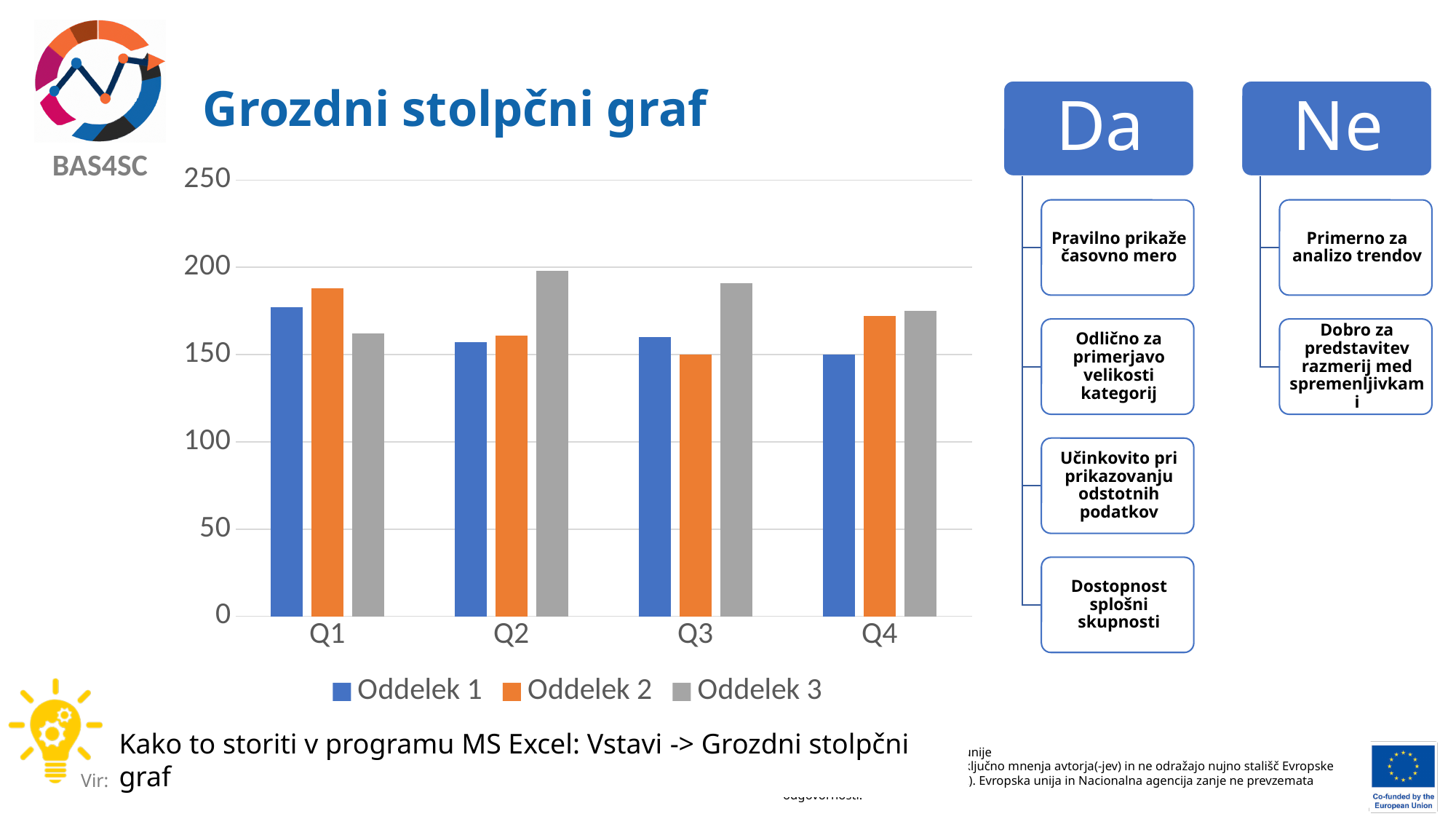
In Q1, which series has the highest bar? Oddelek 2 Is the value for Oddelek 3 in Q3 greater or less than 150? greater In Q2, which series has the highest bar? Oddelek 3 What is the title of the chart? Grozdni stolpčni graf In Q1, which is larger: the value for Oddelek 1 or the value for Oddelek 3? Oddelek 1 Is the value for Oddelek 3 in Q2 greater or less than 150? greater Is the value for Oddelek 1 in Q4 greater or less than 200? less In Q4, which series has the lowest bar? Oddelek 1 What kind of chart is shown on the slide? bar chart How many quarters (categories) are shown on the x axis of the chart? 4 How many series does the chart legend list? 3 Which colour represents Oddelek 2 in the chart? orange